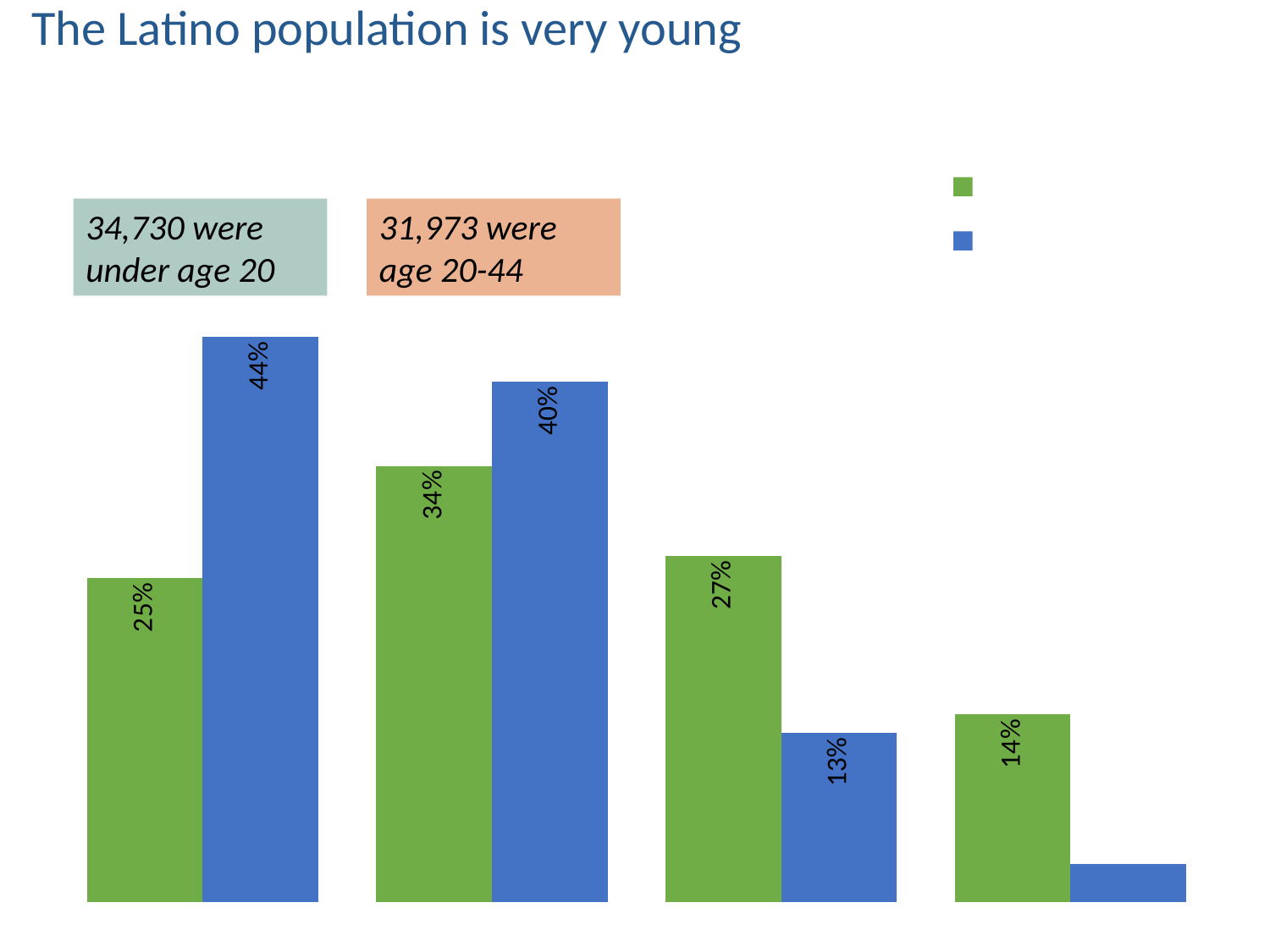
What is the value of the blue bar in the first (leftmost) group? 44% How many series does the legend show? 2 How many groups of bars are plotted along the x axis? 4 What is the value of the blue bar in the third group? 13% Do the blue bars rise or fall from left to right across the groups? fall What is the value of the green bar in the fourth (rightmost) group? 14% What is the value of the green bar in the second group? 34% In the third group, which bar is larger, the green bar or the blue bar? the green bar Which bar has the highest labelled value on the chart? the blue bar in the first group (44%) What is the value of the green bar in the first (leftmost) group? 25% What kind of chart is shown on the slide? bar chart What is the difference between the blue bar and the green bar in the first group? 19 percentage points